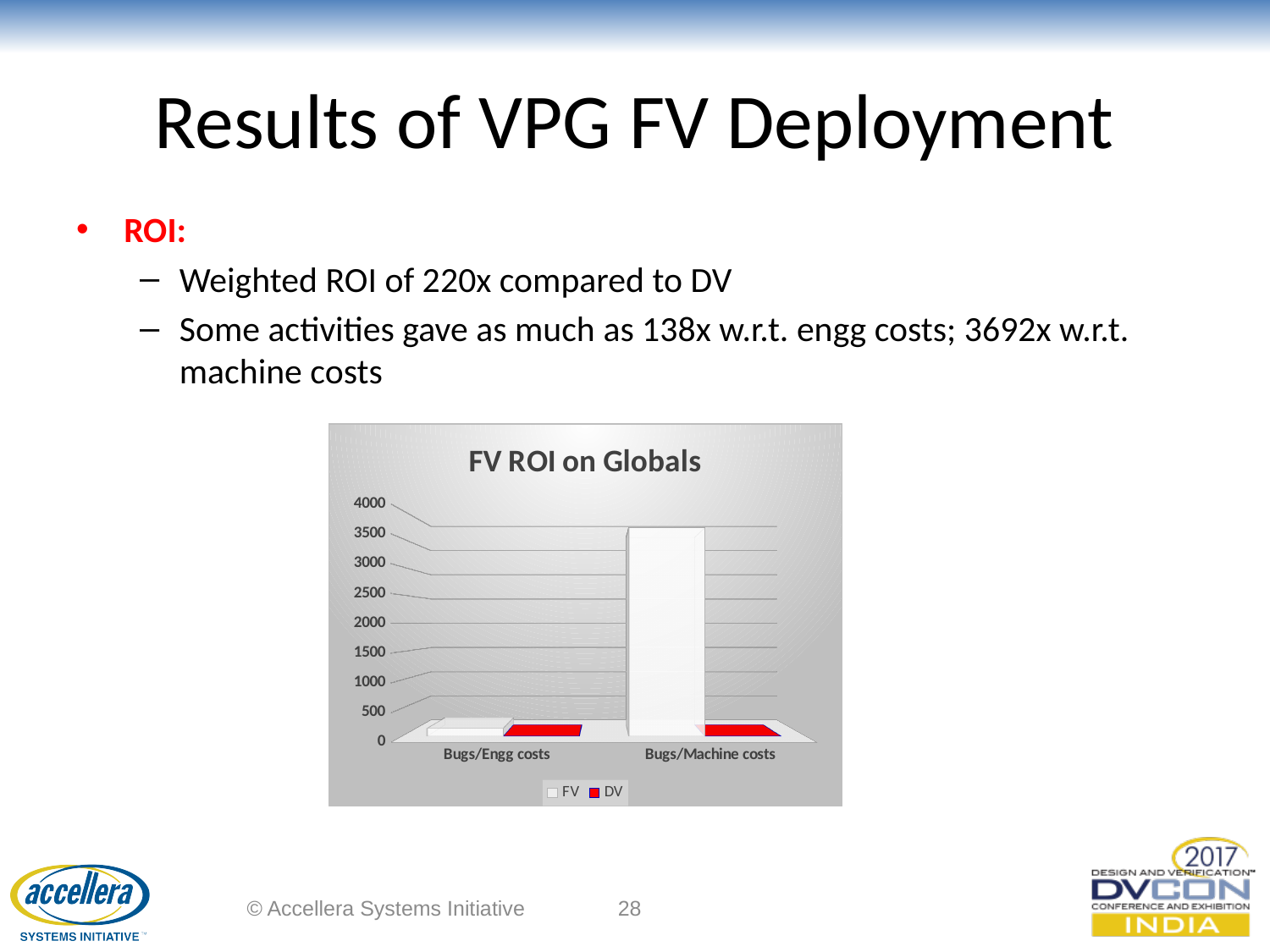
For Bugs/Machine costs, which series has the larger value, FV or DV? FV Which colour represents the DV series in the chart? red Which category has the lowest FV value? Bugs/Engg costs What type of chart is shown on the slide? bar chart Is the FV value for Bugs/Machine costs greater or less than 3000? greater How many categories are shown on the x axis of the chart? 2 Which category has the highest FV value? Bugs/Machine costs How many series does the chart legend list? 2 Is the FV value for Bugs/Machine costs greater or less than 4000? less Which is larger, the FV value for Bugs/Engg costs or the FV value for Bugs/Machine costs? Bugs/Machine costs What is the title of the chart? FV ROI on Globals Is the FV value for Bugs/Engg costs greater or less than 500? less